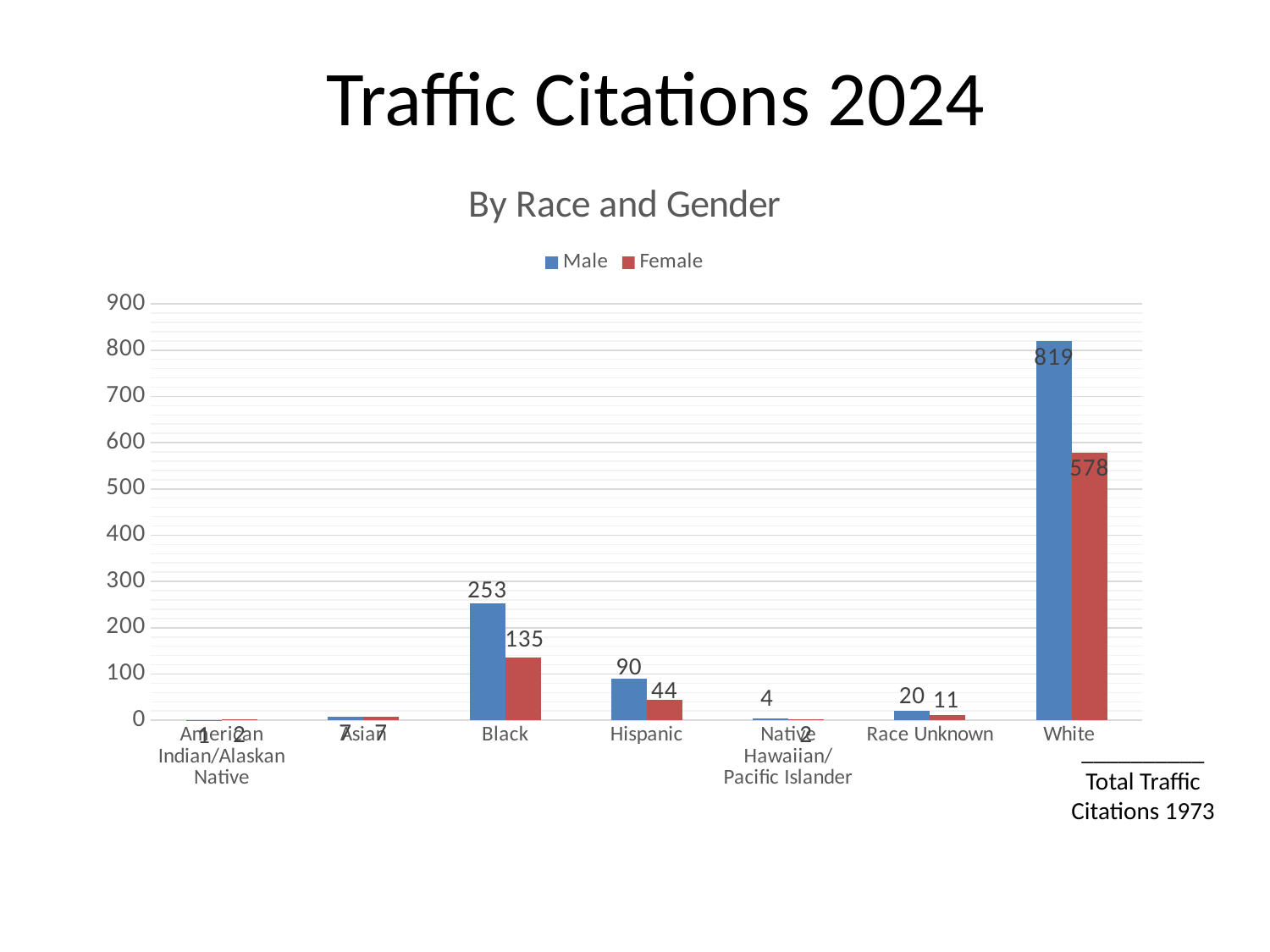
Is the Female value for White greater or less than 500? greater What is the Female value for Race Unknown? 11 What is the Female value for Black? 135 Which category has the highest Male value? White Which is larger, the Female value for Black or the Male value for Hispanic? Female value for Black What is the difference between the Male and Female values for White? 241 What is the Male value for White? 819 How many categories are shown on the x axis? 7 What kind of chart is shown on the slide? bar chart What is the difference between the Male values for Black and Hispanic? 163 What is the Male value for Hispanic? 90 How many series does the legend list? 2